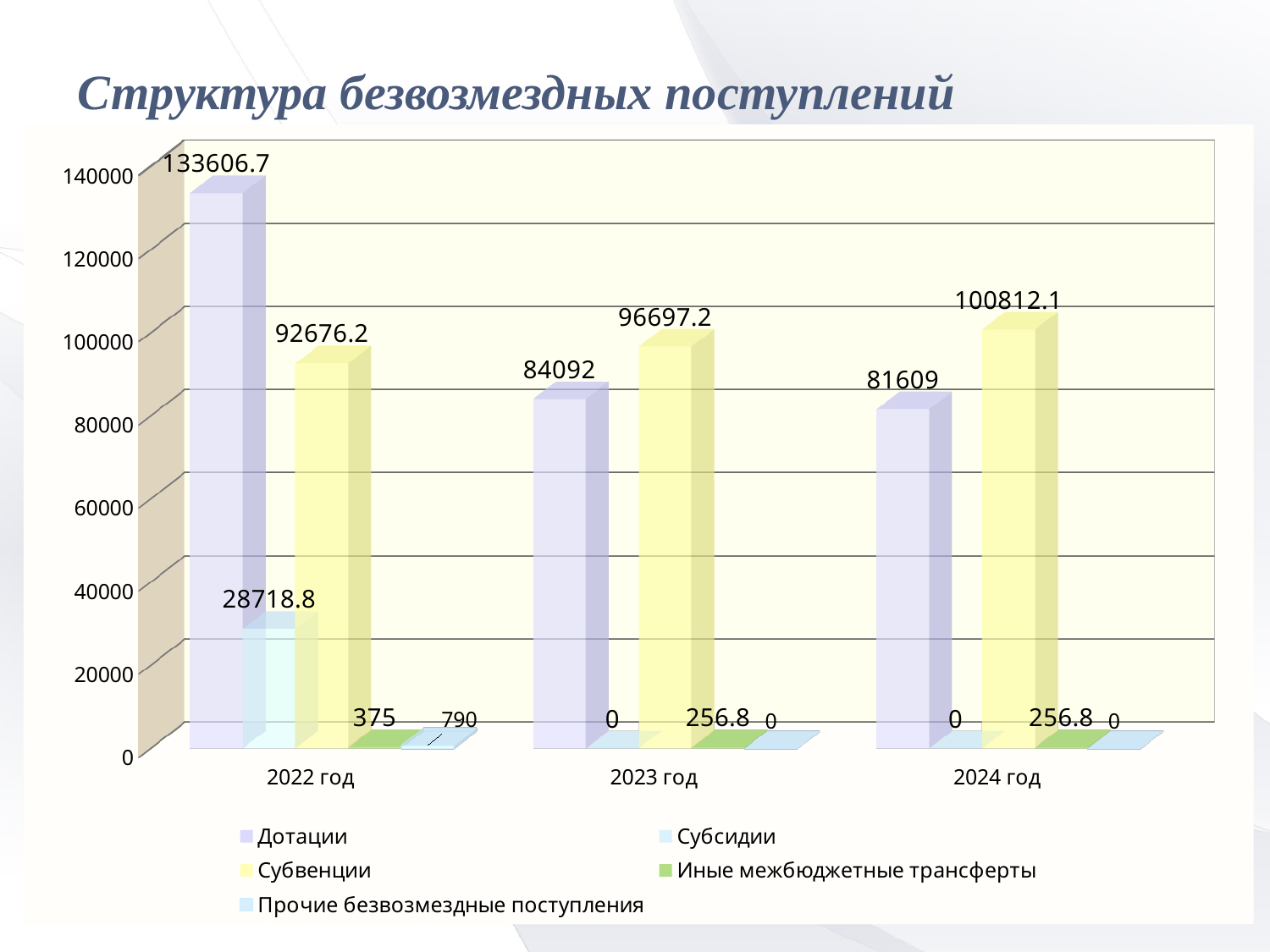
In which year is the value of Дотации the highest? 2022 год What is the value of Дотации for 2022 год? 133606.7 Which is larger in 2023 год: Дотации or Субвенции? Субвенции In which year is the value of Субвенции the lowest? 2022 год What is the value of Субсидии for 2022 год? 28718.8 What is the difference between Субвенции in 2024 год and 2023 год? 4114.9 What is the value of Прочие безвозмездные поступления for 2022 год? 790 What kind of chart is shown on the slide? Bar chart Do the values of Дотации rise or fall from 2022 год to 2024 год? Fall What is the value of Субвенции for 2024 год? 100812.1 What is the value of Иные межбюджетные трансферты for 2023 год? 256.8 How many series does the legend list? 5